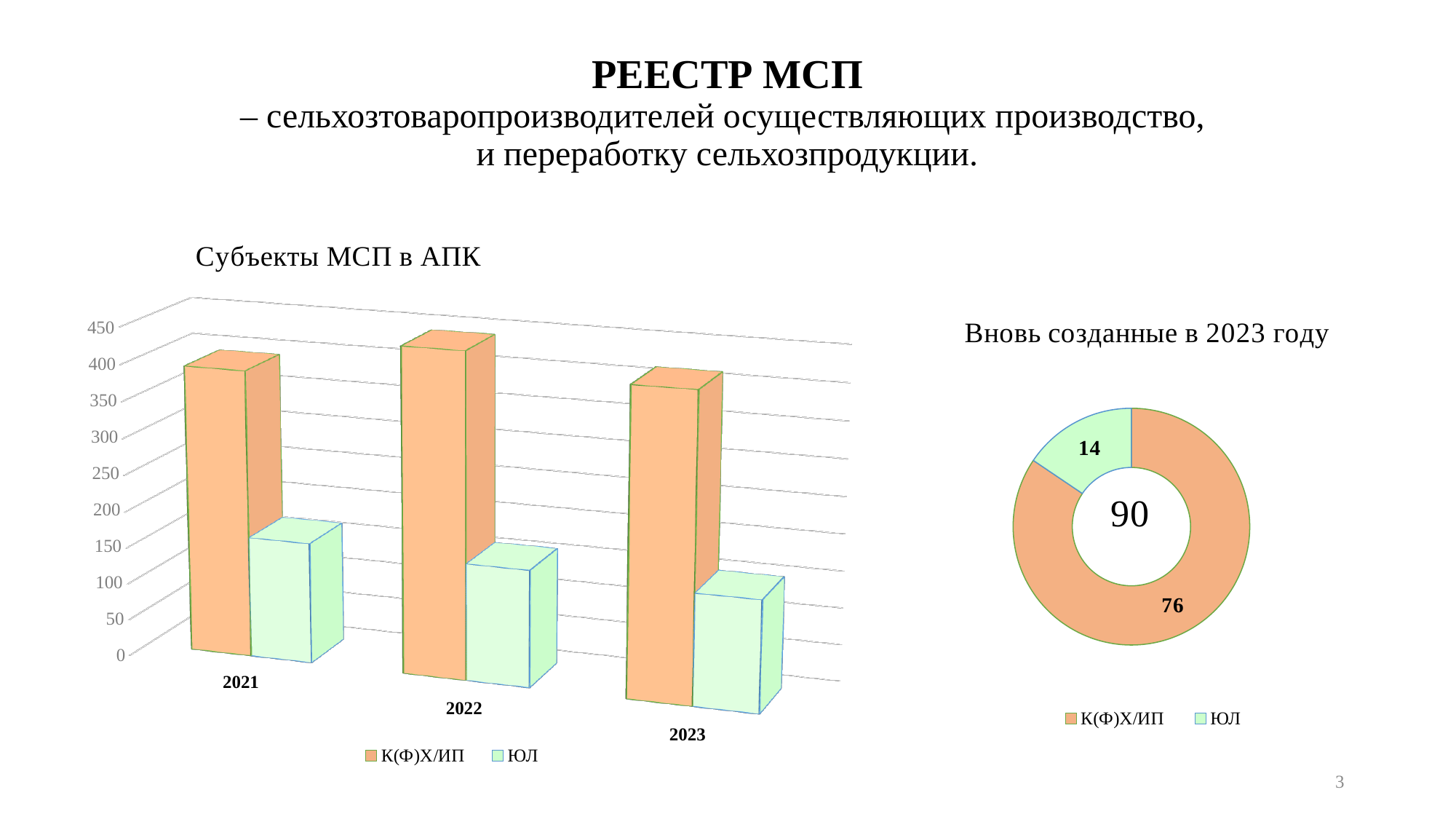
What kind of chart is 'Субъекты МСП в АПК'? Bar chart In the 'Вновь созданные в 2023 году' chart, which category is larger, К(Ф)Х/ИП or ЮЛ? К(Ф)Х/ИП In the 'Вновь созданные в 2023 году' chart, what is the value for К(Ф)Х/ИП? 76 How many years are shown on the x axis of the 'Субъекты МСП в АПК' chart? 3 In the 'Вновь созданные в 2023 году' chart, what total is shown in the centre of the doughnut? 90 In the 'Вновь созданные в 2023 году' chart, what is the difference between К(Ф)Х/ИП and ЮЛ? 62 In the 'Субъекты МСП в АПК' chart, in which year is the К(Ф)Х/ИП bar highest? 2022 In the 'Субъекты МСП в АПК' chart, is the value for ЮЛ in 2023 greater or less than 200? less In the 'Субъекты МСП в АПК' chart, do the ЮЛ values rise or fall from 2021 to 2023? Fall What kind of chart is 'Вновь созданные в 2023 году'? Doughnut chart In the 'Вновь созданные в 2023 году' chart, what is the value for ЮЛ? 14 How many series does the legend of the 'Субъекты МСП в АПК' chart list? 2